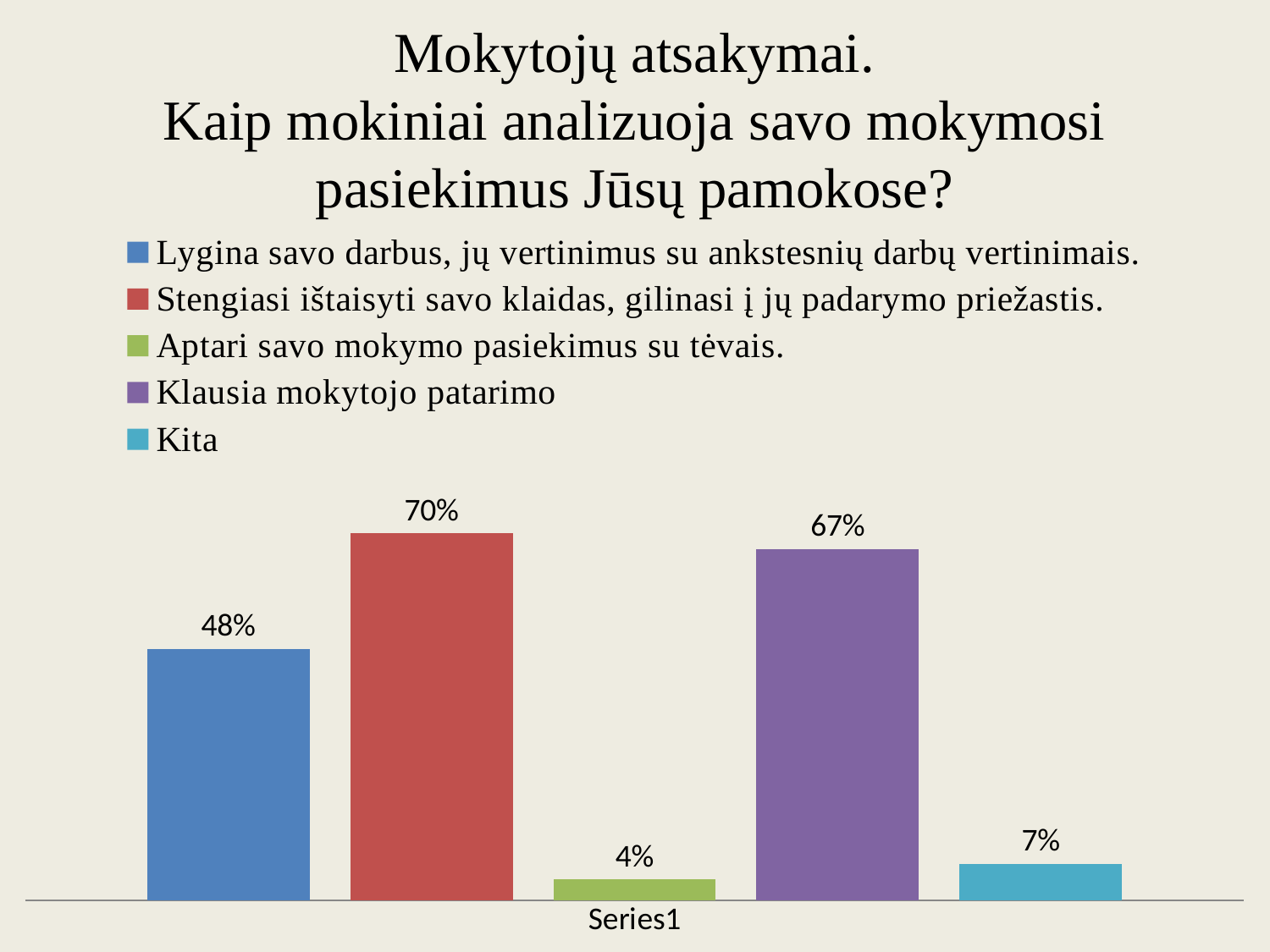
What is the difference between the values for "Stengiasi ištaisyti savo klaidas, gilinasi į jų padarymo priežastis." and "Lygina savo darbus, jų vertinimus su ankstesnių darbų vertinimais."? 22% What is the value for "Stengiasi ištaisyti savo klaidas, gilinasi į jų padarymo priežastis."? 70% What colour is the bar for "Kita"? Light blue How many bars are shown in the chart? 5 What is the value for "Aptari savo mokymo pasiekimus su tėvais."? 4% What is the value for "Klausia mokytojo patarimo"? 67% Which is larger: the value for "Klausia mokytojo patarimo" or the value for "Lygina savo darbus, jų vertinimus su ankstesnių darbų vertinimais."? Klausia mokytojo patarimo Which category has the highest value? Stengiasi ištaisyti savo klaidas, gilinasi į jų padarymo priežastis. What is the value for "Lygina savo darbus, jų vertinimus su ankstesnių darbų vertinimais."? 48% Which category has the lowest value? Aptari savo mokymo pasiekimus su tėvais. What is the value for "Kita"? 7% What kind of chart is shown on the slide? Bar chart